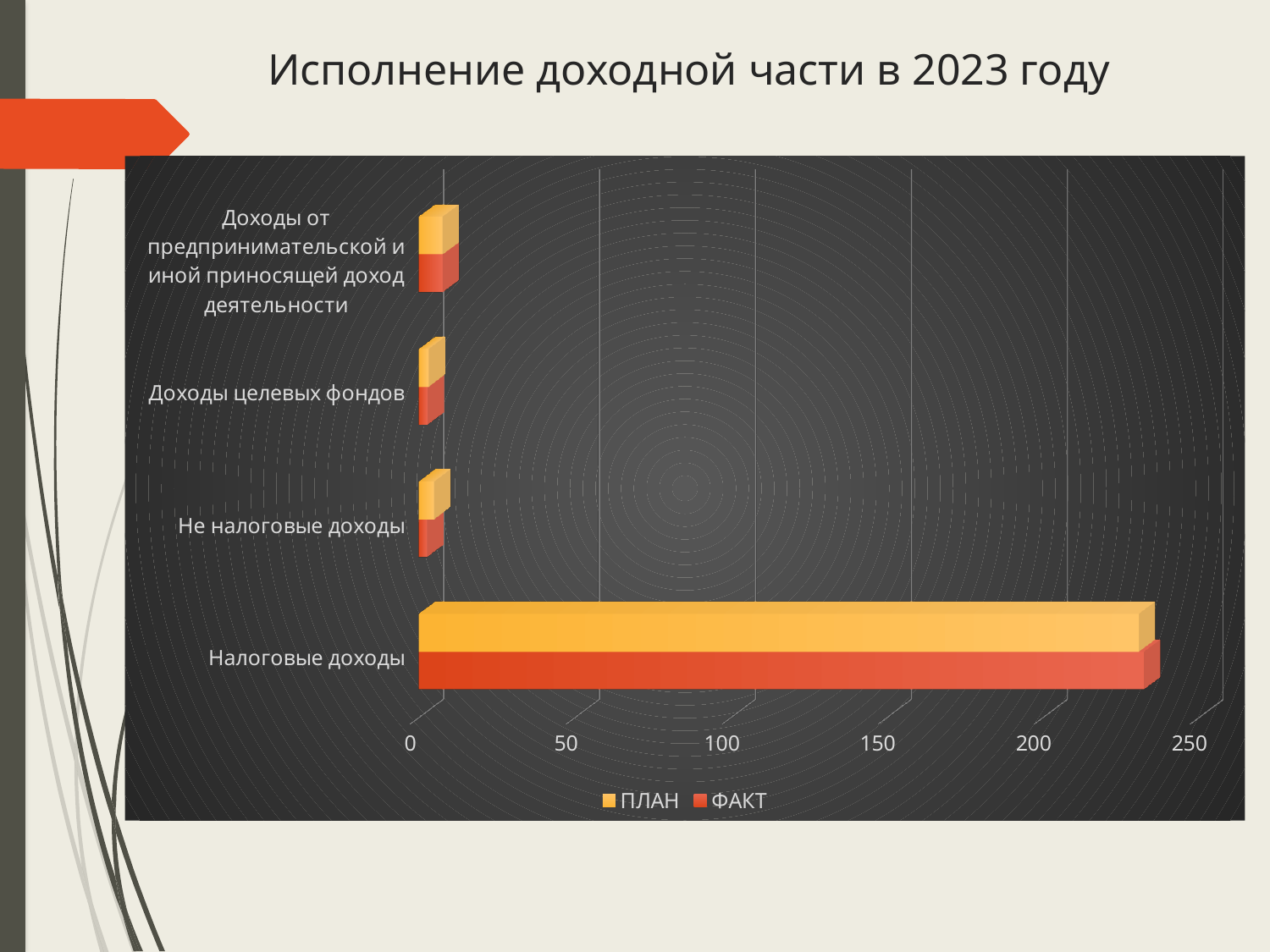
Is the ФАКТ value for Доходы целевых фондов greater or less than 50? less What is the title of the chart? Исполнение доходной части в 2023 году Which series is shown in red in the legend? ФАКТ Which is larger, the ПЛАН value for Налоговые доходы or the ПЛАН value for Не налоговые доходы? Налоговые доходы Which category has the highest ФАКТ value? Налоговые доходы Is the ПЛАН value for Налоговые доходы greater or less than 200? greater How many categories are shown on the chart? 4 What kind of chart is shown on the slide? bar chart How many series does the legend list? 2 Is the ФАКТ value for Налоговые доходы greater or less than 150? greater Which category has the highest ПЛАН value? Налоговые доходы